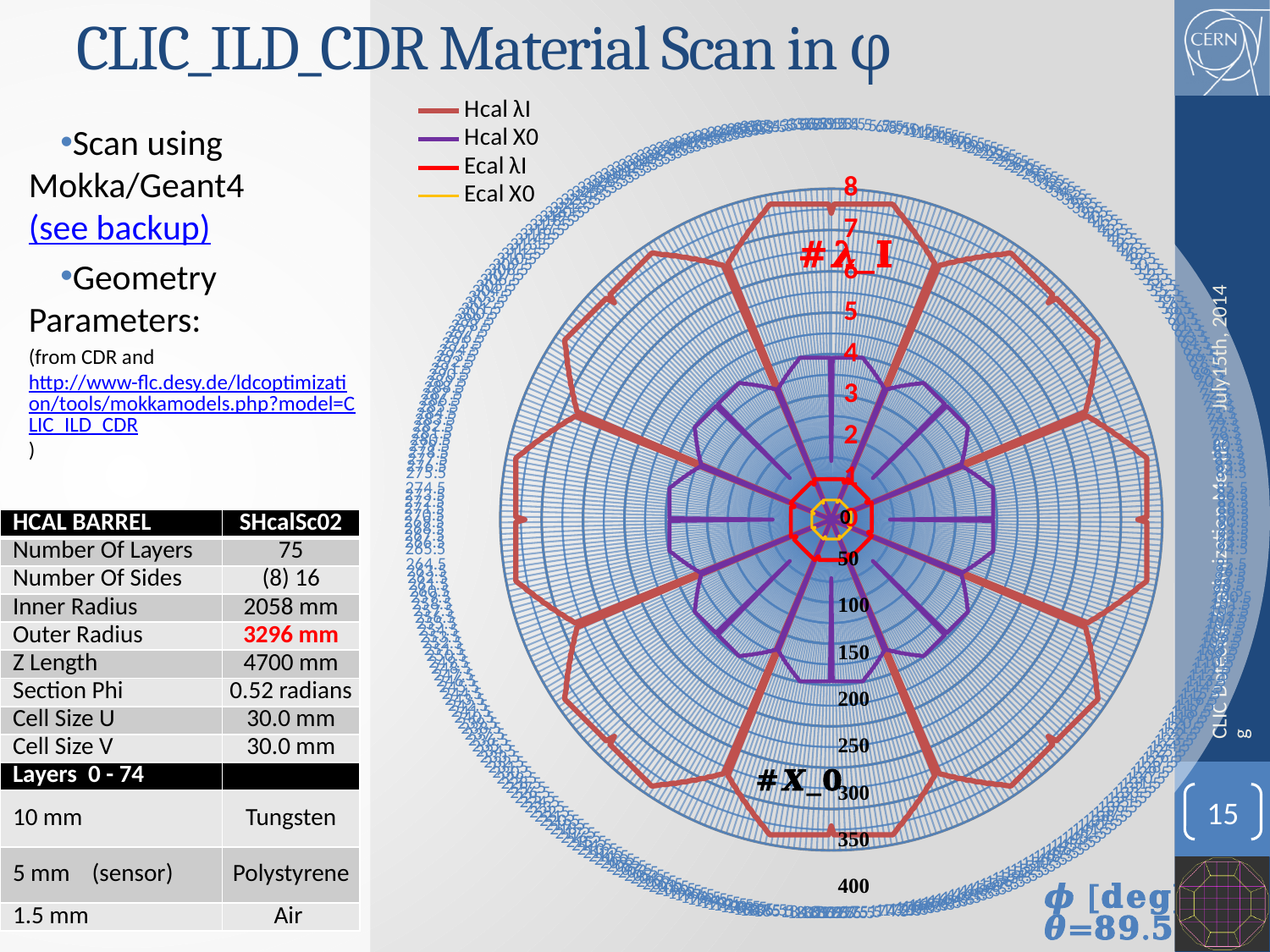
Which series has larger values, Hcal X0 or Ecal X0? Hcal X0 Which series is drawn in purple in the chart? Hcal X0 Which series extends farthest from the centre of the chart? Hcal λI Which series has larger values, Hcal λI or Ecal λI? Hcal λI Which series stays closest to the centre of the chart? Ecal X0 How many series does the chart legend list? 4 What kind of chart is shown on the slide? radar chart Which series is drawn in yellow in the chart? Ecal X0 Is the value of Ecal λI greater or less than 2 on the λI axis? less Is the value of Hcal λI greater or less than 4 on the λI axis? greater What is the highest tick label shown on the X0 radial axis of the chart? 400